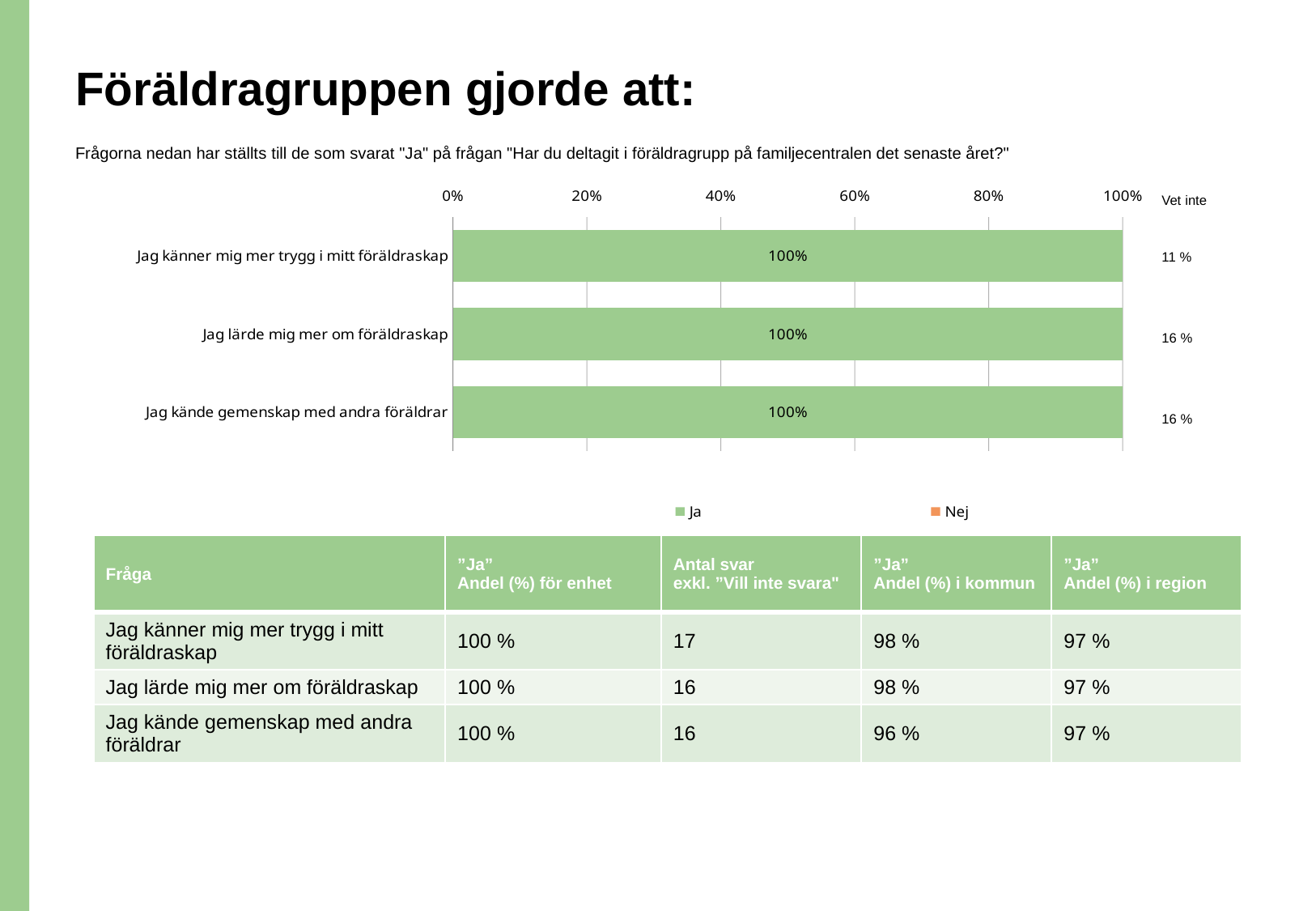
What is the "Ja" value for "Jag kände gemenskap med andra föräldrar"? 100% What is the highest value shown on the chart's percentage axis? 100% How many categories are shown in the bar chart? 3 What is the "Vet inte" value shown next to the bar for "Jag kände gemenskap med andra föräldrar"? 16 % What colour are the "Ja" bars in the chart? Green What is the "Ja" value for "Jag lärde mig mer om föräldraskap"? 100% Is the "Ja" value for "Jag lärde mig mer om föräldraskap" greater or less than 80%? greater What is the "Vet inte" value shown next to the bar for "Jag känner mig mer trygg i mitt föräldraskap"? 11 % How many series does the chart legend list? 2 What kind of chart is shown on the slide? Bar chart What are the two series named in the chart legend? Ja and Nej What is the "Ja" value for "Jag känner mig mer trygg i mitt föräldraskap"? 100%